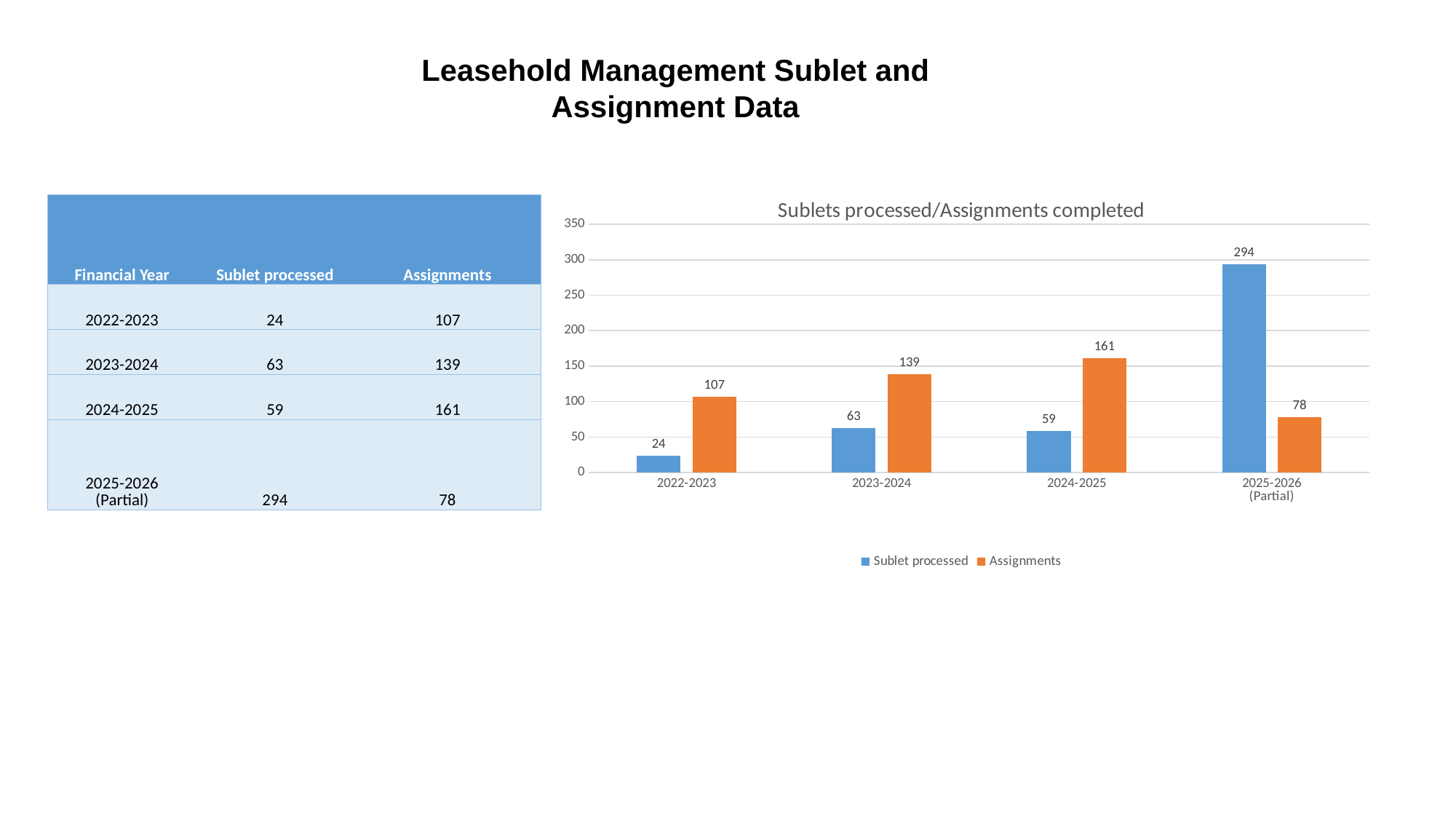
Which financial year has the lowest value for Sublet processed? 2022-2023 What is the difference between Assignments and Sublet processed in 2023-2024? 76 How many financial years are shown on the x axis of the chart? 4 Do the Assignments values rise or fall from 2022-2023 to 2024-2025? Rise What is the title of the chart? Sublets processed/Assignments completed What is the value for Sublet processed in 2022-2023? 24 Which is larger in 2025-2026 (Partial): Sublet processed or Assignments? Sublet processed What is the value for Sublet processed in 2025-2026 (Partial)? 294 Which financial year has the highest value for Assignments? 2024-2025 How many series does the chart legend list? 2 What kind of chart is shown on the slide? Bar chart What is the value for Assignments in 2024-2025? 161